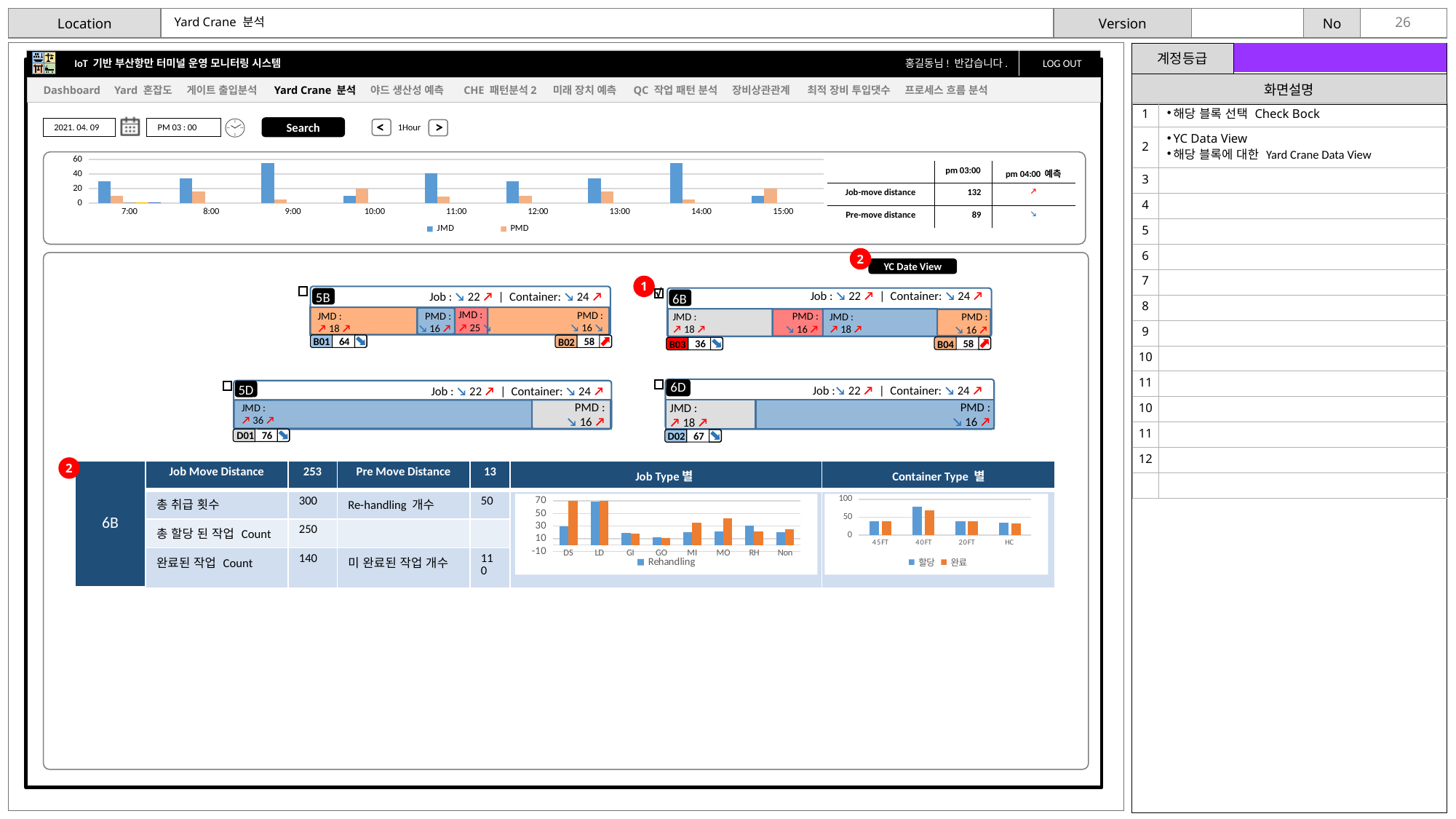
In the top JMD/PMD chart, is the JMD value at 10:00 greater or less than 20? less In the 'Job Type 별' chart, is the orange bar for DS greater or less than 50? greater In the 'Job Type 별' chart, which category has the lowest values? GO In the top JMD/PMD chart, how many hourly categories are shown on the x axis? 9 What kind of chart is the top chart showing JMD and PMD by hour? bar chart In the 'Job Type 별' chart, how many job type categories are shown on the x axis? 8 In the 'Container Type 별' chart, is the 할당 value for 40FT greater or less than 50? greater In the top JMD/PMD chart, which series has the larger value at 10:00, JMD or PMD? PMD In the 'Container Type 별' chart, which category has the highest values? 40FT In the top JMD/PMD chart, how many series does the legend list? 2 In the top JMD/PMD chart, which series has the larger value at 7:00, JMD or PMD? JMD